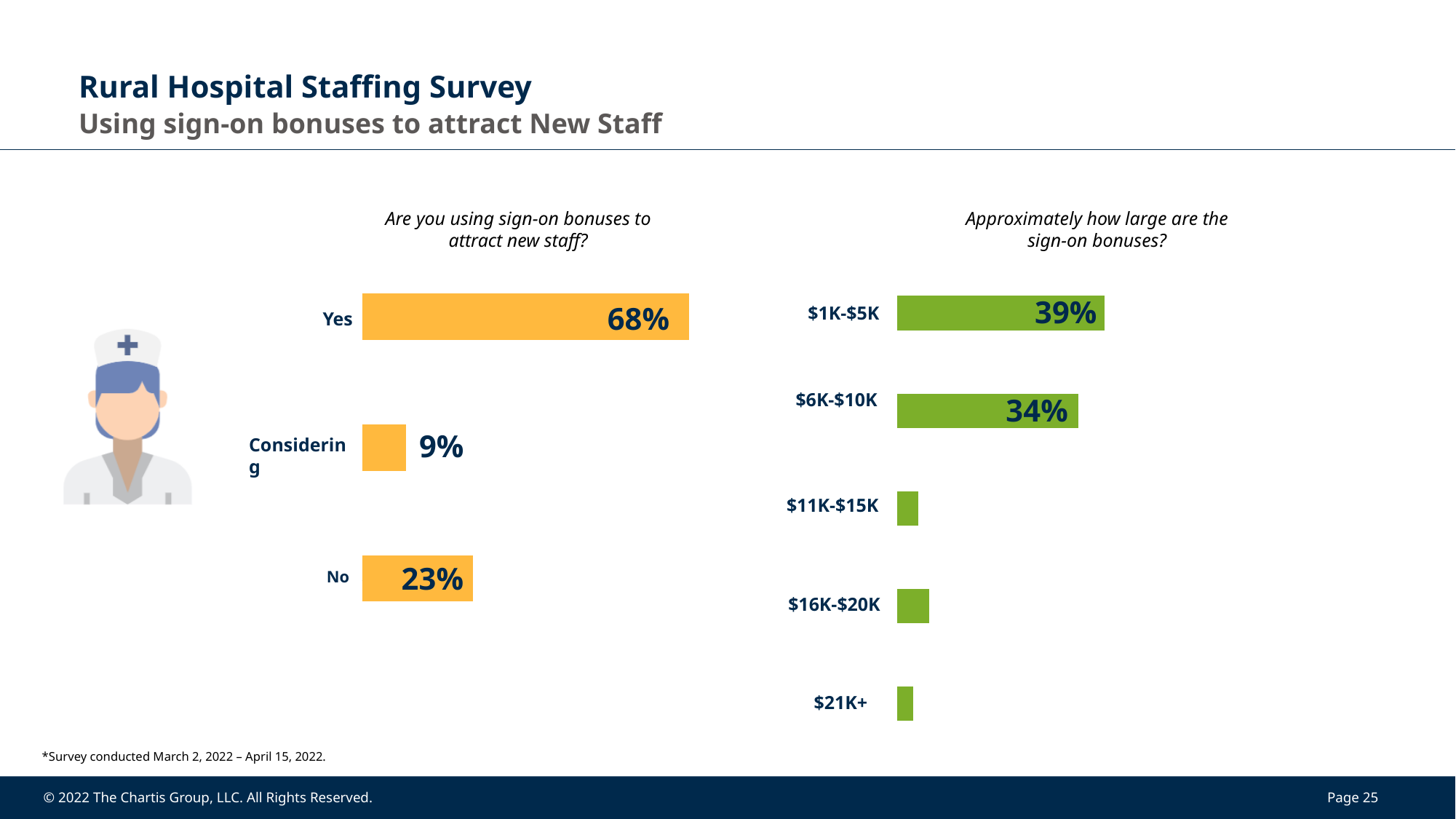
In the chart 'Are you using sign-on bonuses to attract new staff?', what is the difference between the Yes and No percentages? 45% What type of chart is 'Are you using sign-on bonuses to attract new staff?' Bar chart In the chart 'Are you using sign-on bonuses to attract new staff?', what percentage are Considering? 9% In the chart 'Are you using sign-on bonuses to attract new staff?', which response has the lowest percentage? Considering In the chart 'Approximately how large are the sign-on bonuses?', which bonus range has the highest percentage? $1K-$5K In the chart 'Are you using sign-on bonuses to attract new staff?', what percentage answered No? 23% In the chart 'Approximately how large are the sign-on bonuses?', how many bonus ranges are shown? 5 In the chart 'Approximately how large are the sign-on bonuses?', what percentage is shown for $1K-$5K? 39% In the chart 'Are you using sign-on bonuses to attract new staff?', what percentage answered Yes? 68% In the chart 'Approximately how large are the sign-on bonuses?', what percentage is shown for $6K-$10K? 34% In the chart 'Approximately how large are the sign-on bonuses?', which is larger, the value for $16K-$20K or the value for $21K+? $16K-$20K What colour are the bars in the chart 'Approximately how large are the sign-on bonuses?' Green